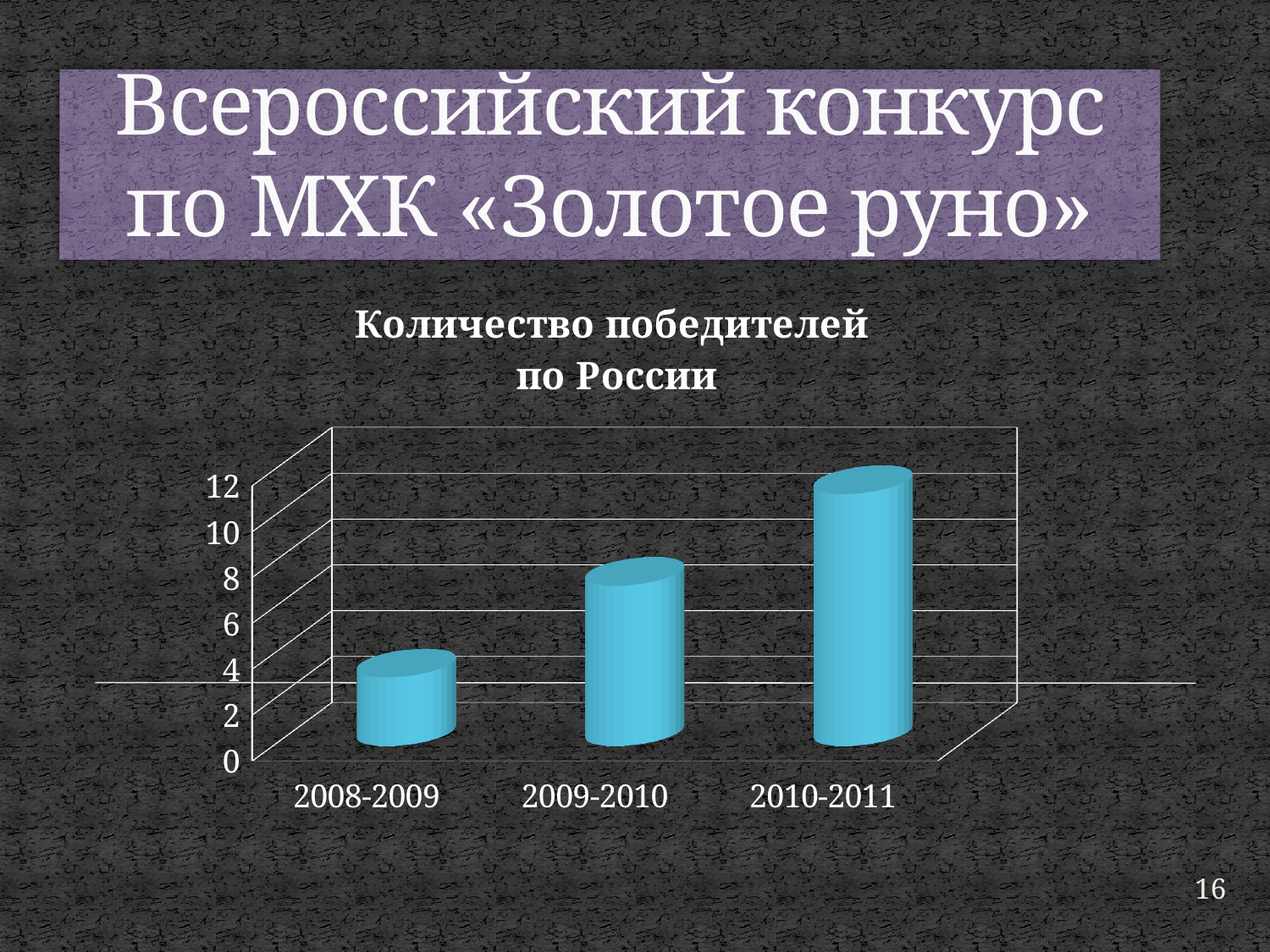
Is the value for 2010-2011 greater or less than 10? greater What kind of chart is shown on the slide? bar chart Which is larger, the value for 2010-2011 or the value for 2009-2010? 2010-2011 Which is larger, the value for 2009-2010 or the value for 2008-2009? 2009-2010 Do the values rise or fall from 2008-2009 to 2010-2011? rise How many categories are shown on the x axis of the chart? 3 Is the value for 2009-2010 greater or less than 6? greater What colour are the bars in the chart? blue Which period has the lowest number of winners? 2008-2009 What is the title of the chart? Количество победителей по России Is the value for 2008-2009 greater or less than 6? less Which period has the highest number of winners? 2010-2011